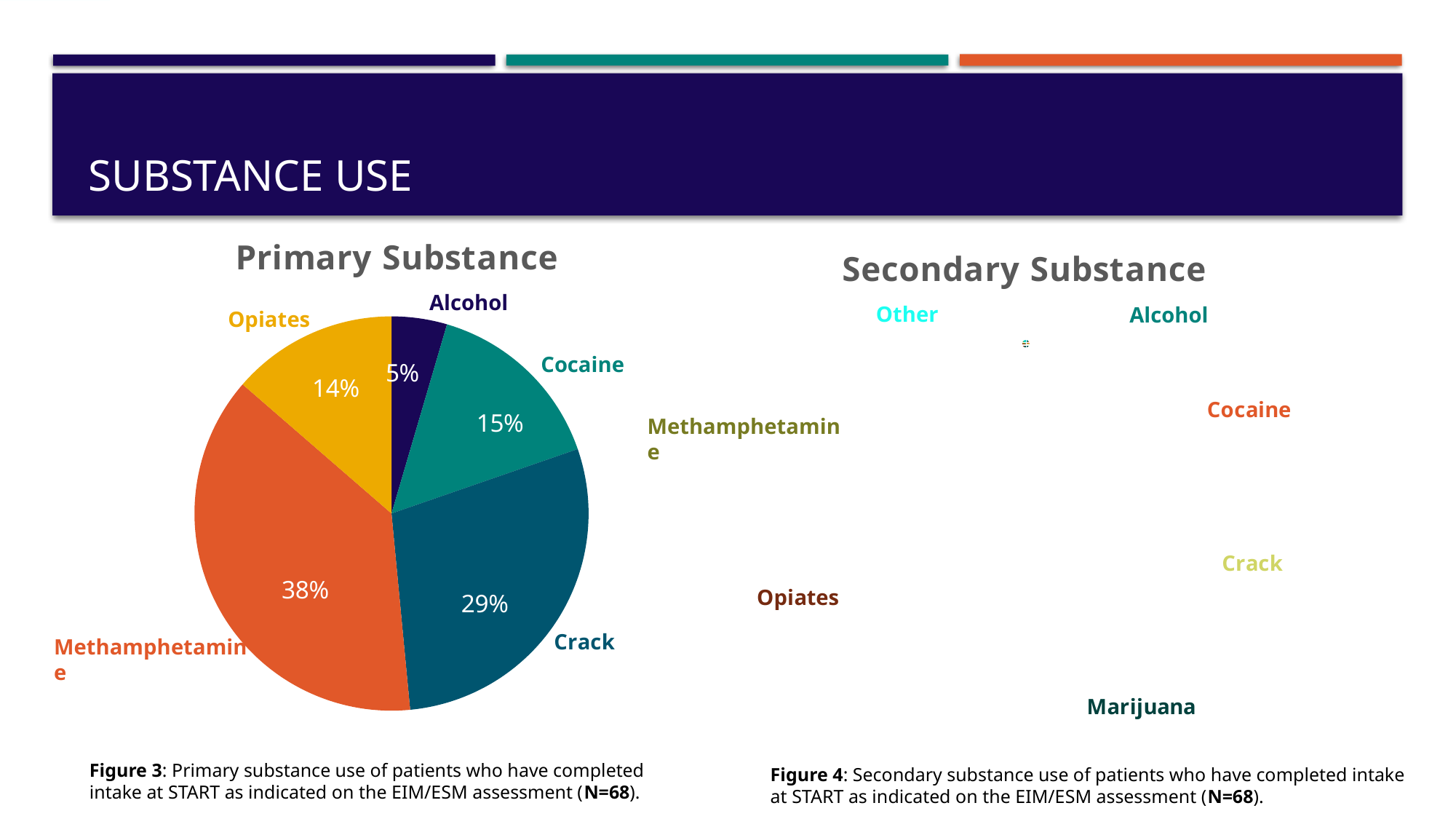
In the Primary Substance chart, which substance has the smallest share? Alcohol In the Primary Substance chart, what percentage is shown for Crack? 29% In the Primary Substance chart, what percentage is shown for Opiates? 14% What is the title of the chart on the right side of the slide? Secondary Substance In the Primary Substance chart, how many percentage points larger is the Methamphetamine share than the Crack share? 9 percentage points In the Primary Substance chart, what percentage is shown for Cocaine? 15% In the Primary Substance chart, what percentage is shown for Methamphetamine? 38% In the Primary Substance chart, which substance has the largest share? Methamphetamine How many substance categories are shown in the Primary Substance chart? 5 What type of chart is the Primary Substance chart? Pie chart In the Primary Substance chart, what percentage is shown for Alcohol? 5% In the Primary Substance chart, which has the larger share, Cocaine or Opiates? Cocaine